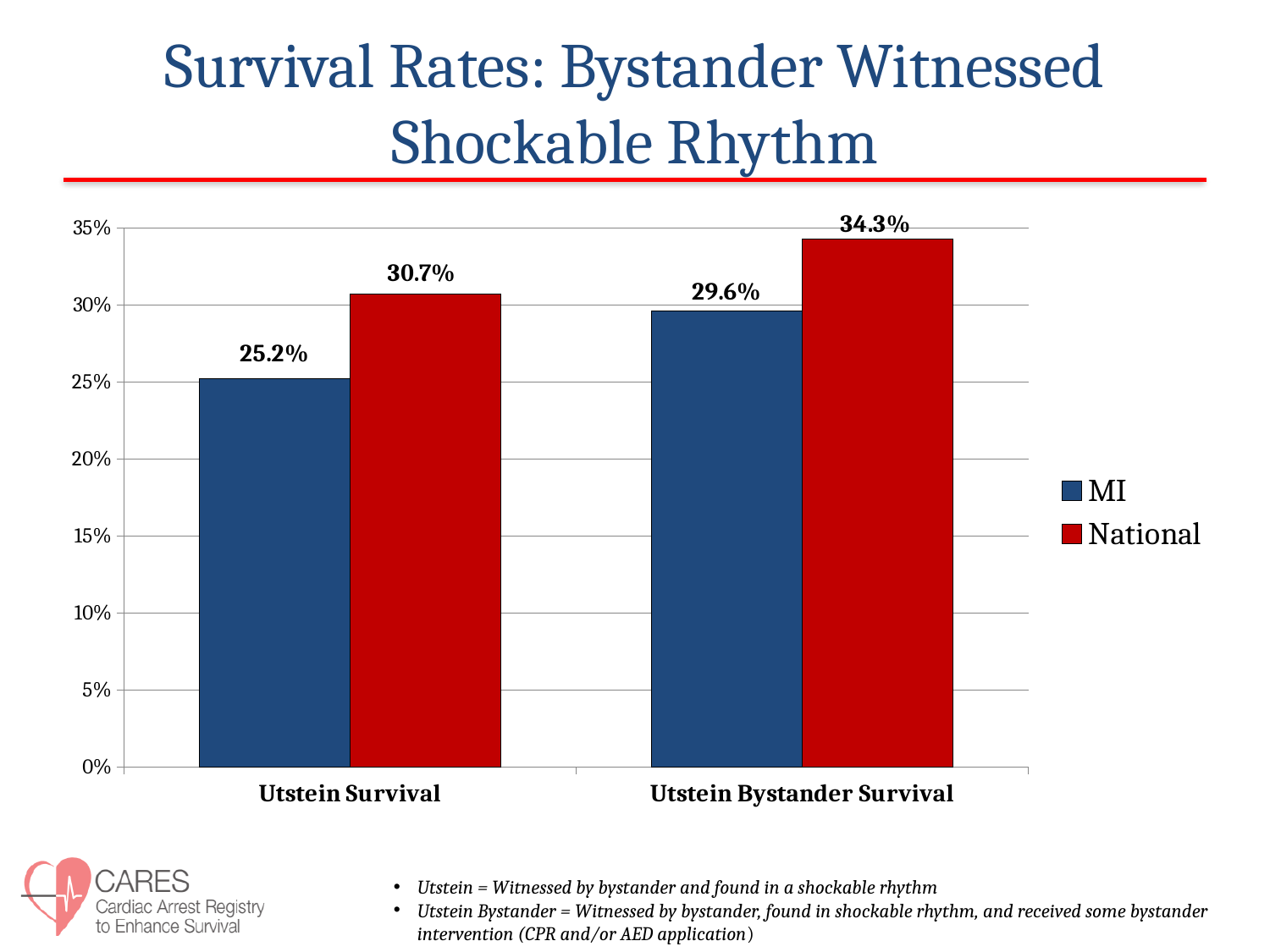
Which is larger for Utstein Bystander Survival, MI or National? National How many categories are shown on the x axis? 2 What is the National value for Utstein Bystander Survival? 34.3% What is the MI value for Utstein Bystander Survival? 29.6% How many series does the legend list? 2 What is the difference between the National and MI values for Utstein Bystander Survival? 4.7% What is the difference between the National and MI values for Utstein Survival? 5.5% What is the MI value for Utstein Survival? 25.2% Which bar has the highest value on the chart? National, Utstein Bystander Survival Which bar has the lowest value on the chart? MI, Utstein Survival What kind of chart is shown on the slide? Bar chart What is the National value for Utstein Survival? 30.7%